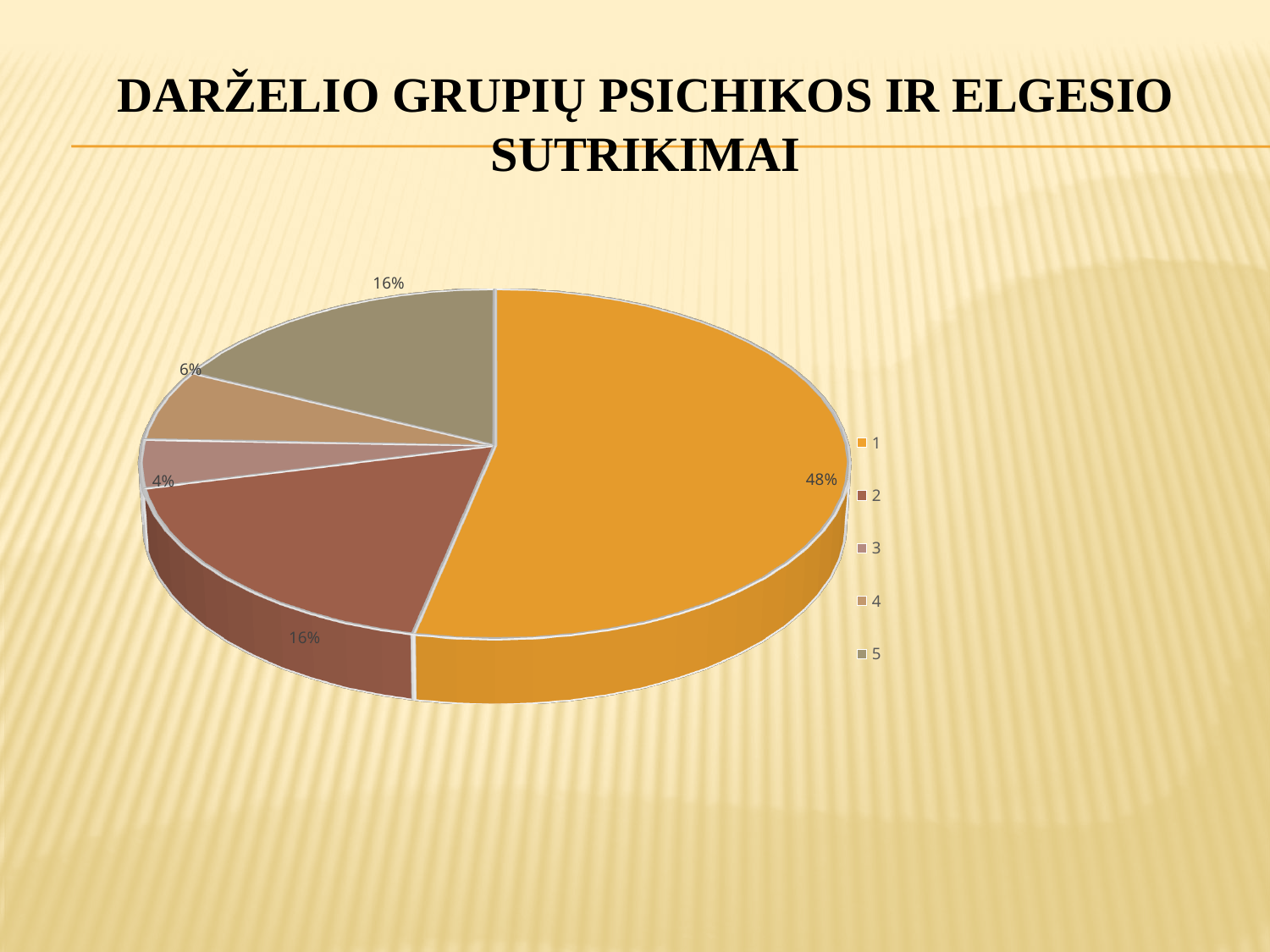
Which is larger, the value for category 4 or the value for category 3? 4 Which category has the smallest slice? 3 What is the title of the slide containing the chart? DARŽELIO GRUPIŲ PSICHIKOS IR ELGESIO SUTRIKIMAI Which category has the largest slice? 1 What is the value for category 2? 16% What is the value for category 3? 4% What is the value for category 4? 6% What kind of chart is shown on the slide? pie chart What is the value for category 1? 48% What is the value for category 5? 16% How many slices does the pie chart have? 5 What is the difference between the values for category 1 and category 2? 32%